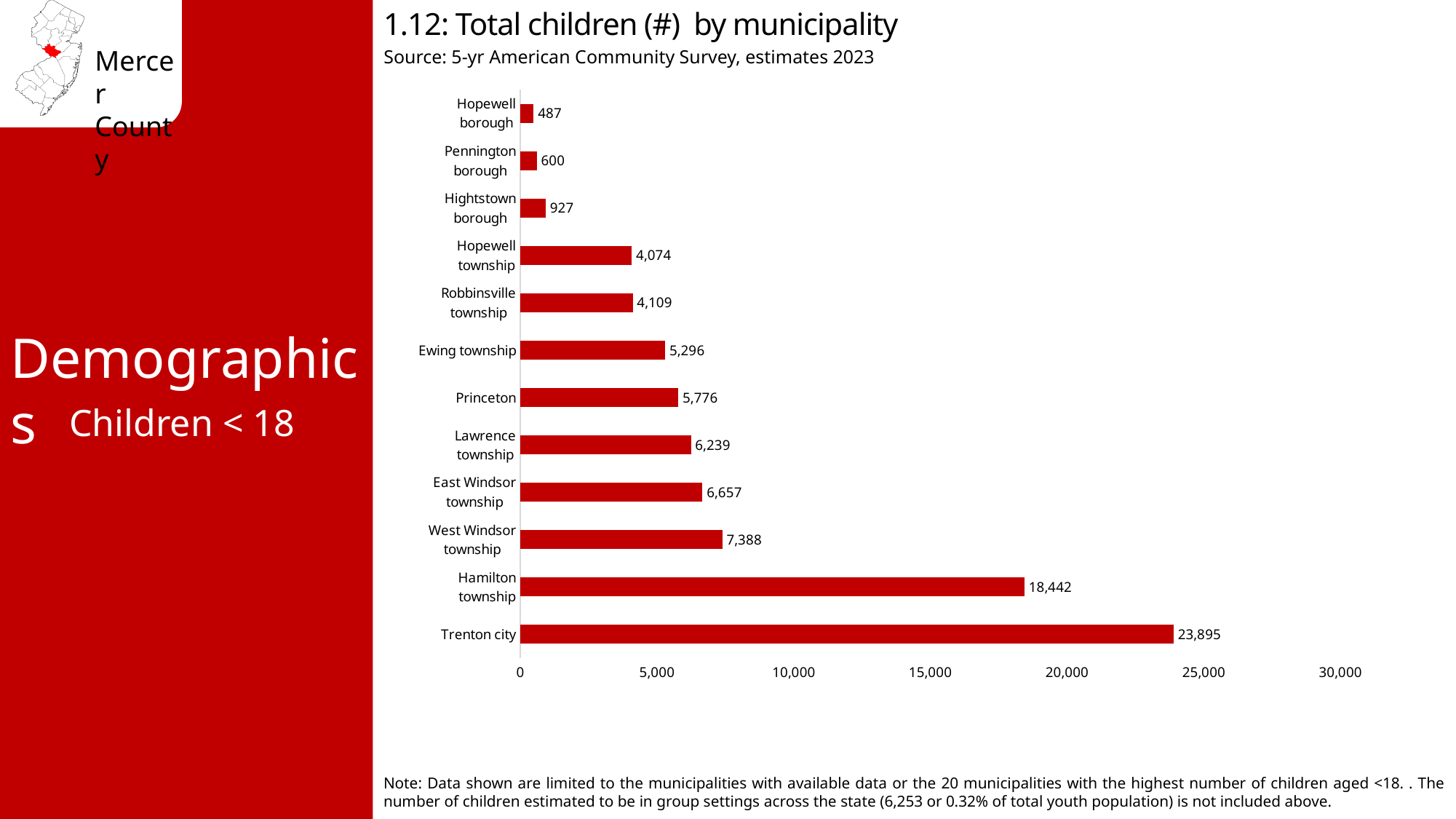
What is the total number of children in Trenton city? 23,895 What is the total number of children in Hamilton township? 18,442 What is the source of the data shown in the chart? 5-yr American Community Survey, estimates 2023 Which municipality has the highest number of children? Trenton city What is the difference in the number of children between Robbinsville township and Hopewell township? 35 Which has more children, West Windsor township or East Windsor township? West Windsor township What is the difference in the number of children between Trenton city and Hamilton township? 5,453 How many municipalities are shown in the chart? 12 What kind of chart is shown on the slide? bar chart Which municipality has the lowest number of children? Hopewell borough Is the value for Ewing township greater or less than 5,000? greater What is the total number of children in Princeton? 5,776